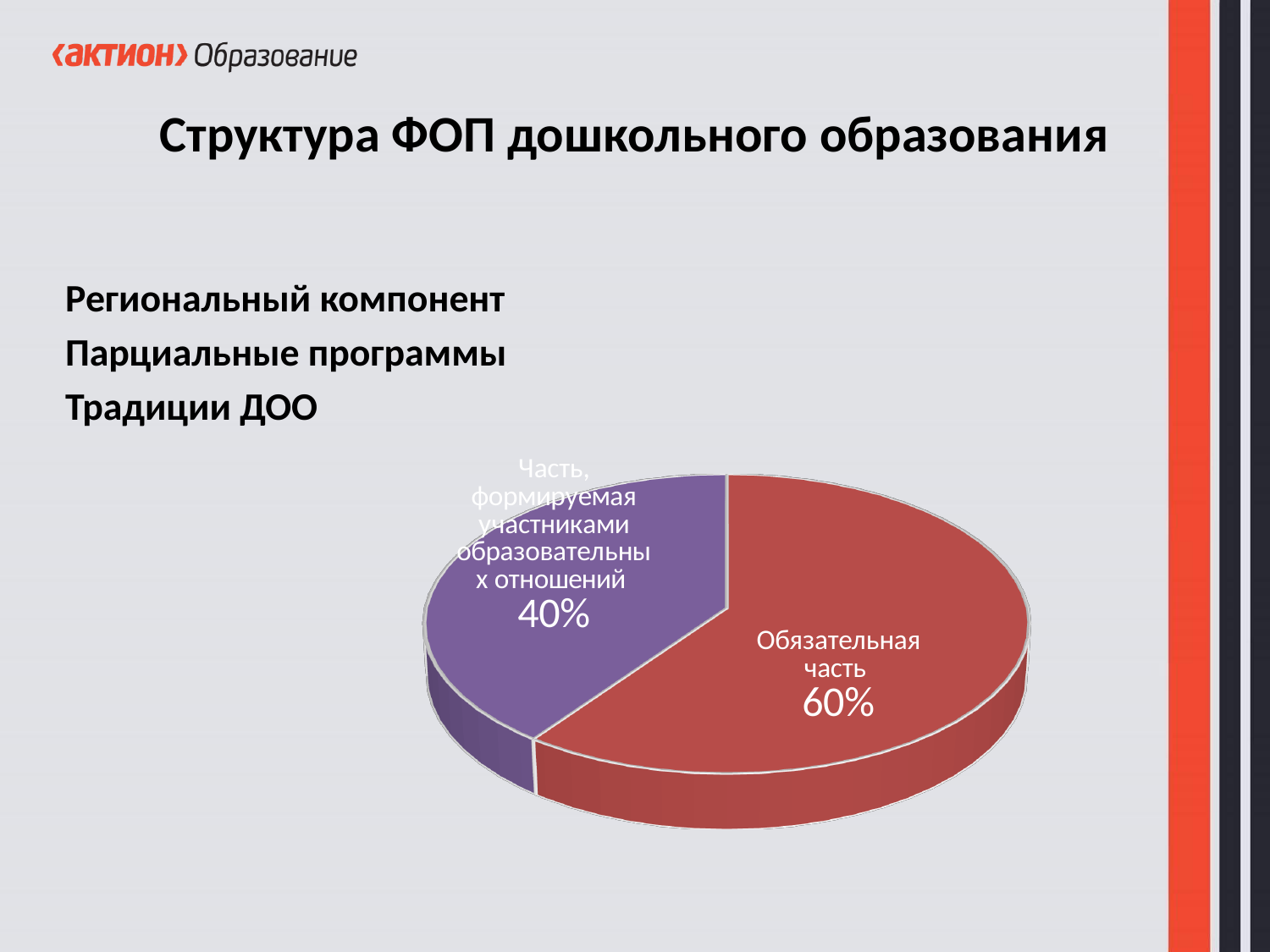
What share of the pie does "Обязательная часть" take? 60% Which slice of the pie is the smallest? Часть, формируемая участниками образовательных отношений What colour is the "Часть, формируемая участниками образовательных отношений" slice? Purple Is the share for "Обязательная часть" greater or less than 50%? greater What is the difference in percentage points between "Обязательная часть" and "Часть, формируемая участниками образовательных отношений"? 20 percentage points Which slice of the pie is the largest? Обязательная часть Which is larger: "Обязательная часть" or "Часть, формируемая участниками образовательных отношений"? Обязательная часть What colour is the "Обязательная часть" slice? Red How many slices does the pie chart have? 2 What share of the pie does "Часть, формируемая участниками образовательных отношений" take? 40% What kind of chart is shown on the slide? Pie chart